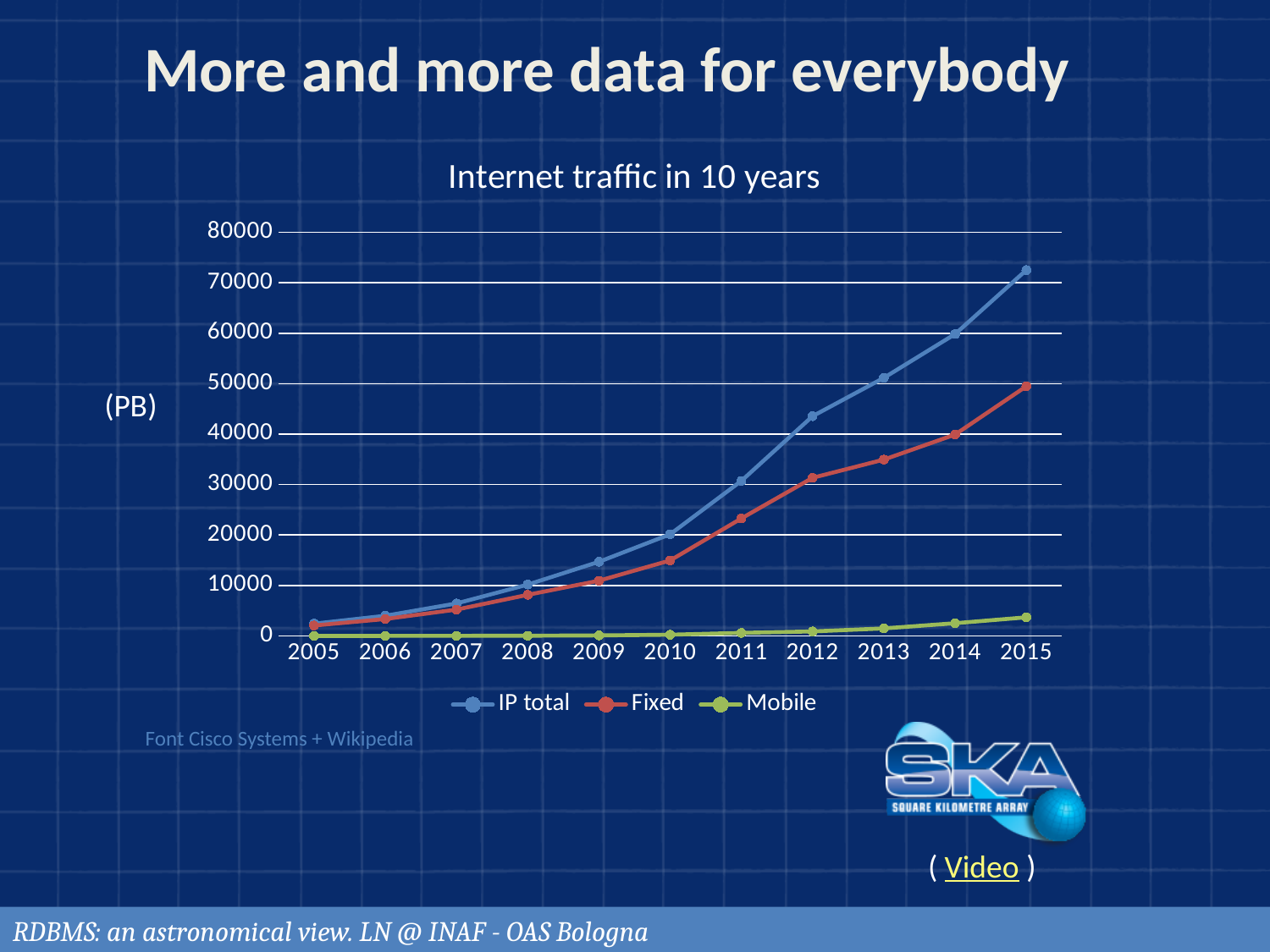
In which year is the Fixed series at its lowest? 2005 In 2015, which series is larger, IP total or Fixed? IP total How many years are plotted along the x axis of the chart? 11 Is the value for Mobile in 2015 greater or less than 10000? less How many series does the chart legend list? 3 In which year is the IP total series at its highest? 2015 Does the IP total series rise or fall from 2005 to 2015? rise What unit is shown on the y axis of the chart? PB Is the value for Fixed in 2008 greater or less than 10000? less Is the value for IP total in 2015 greater or less than 60000? greater What is the title of the chart? Internet traffic in 10 years What kind of chart is shown on the slide? line chart